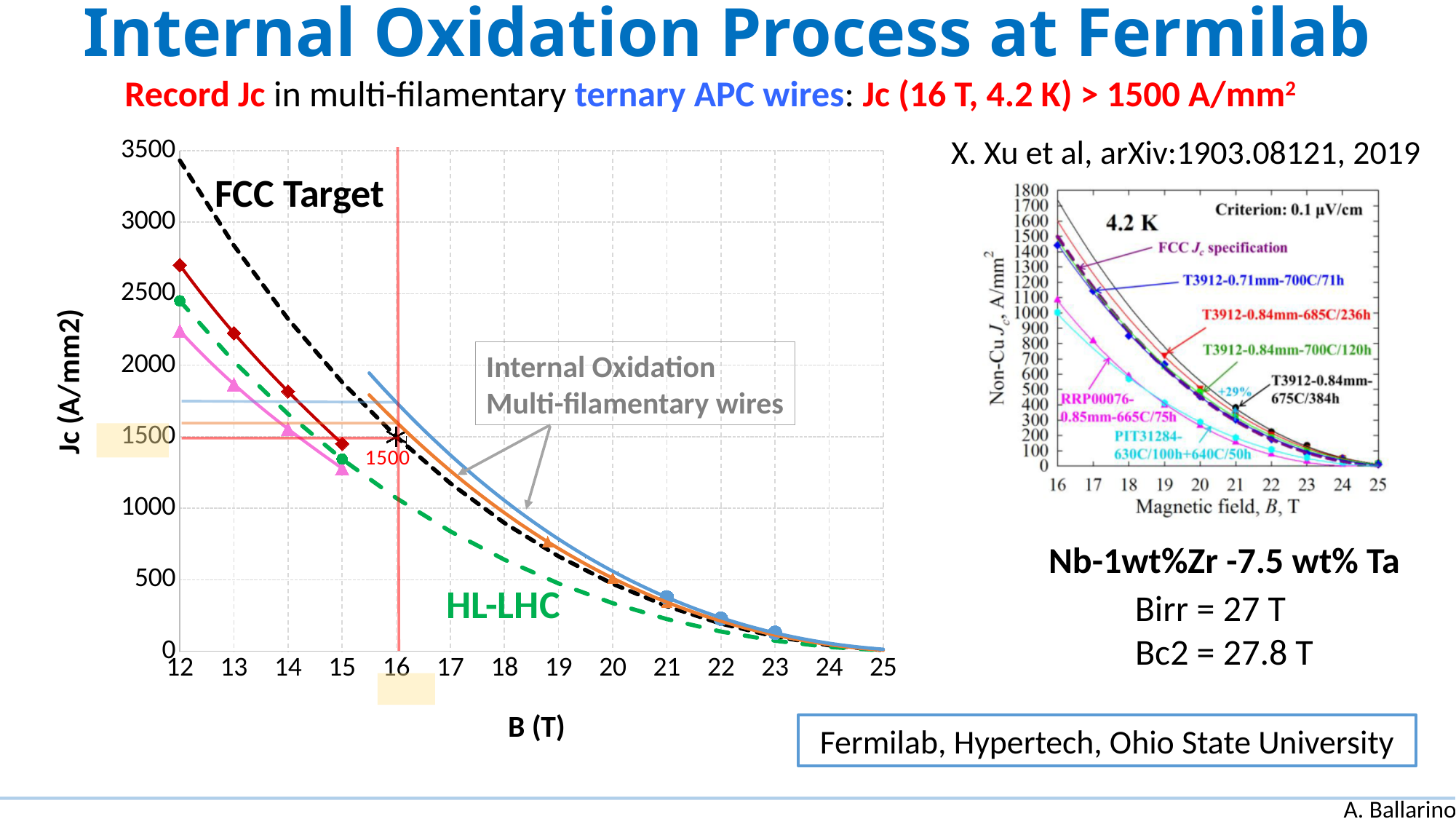
On the left chart, does the FCC Target curve rise or fall as B increases? fall On the right chart (X. Xu et al), do the Jc curves rise or fall as the magnetic field increases? fall On the right chart (X. Xu et al), is the RRP00076-0.85mm-665C/75h value at 16 T greater or less than 1200? less On the right chart (X. Xu et al), what temperature is indicated on the plot? 4.2 K What kind of chart is the large chart on the left of the slide? line chart On the left chart, what Jc value is labelled at the marker at 16 T? 1500 On the left chart, what is the label of the y axis? Jc (A/mm2) On the left chart, which curve is higher at 12 T, FCC Target or HL-LHC? FCC Target On the left chart, what is the highest value shown on the x axis? 25 On the right chart (X. Xu et al), what is the lowest magnetic field value shown on the x axis? 16 On the left chart, is the HL-LHC value at 16 T greater or less than 1500? less On the left chart, is the FCC Target value at 12 T greater or less than 3000? greater